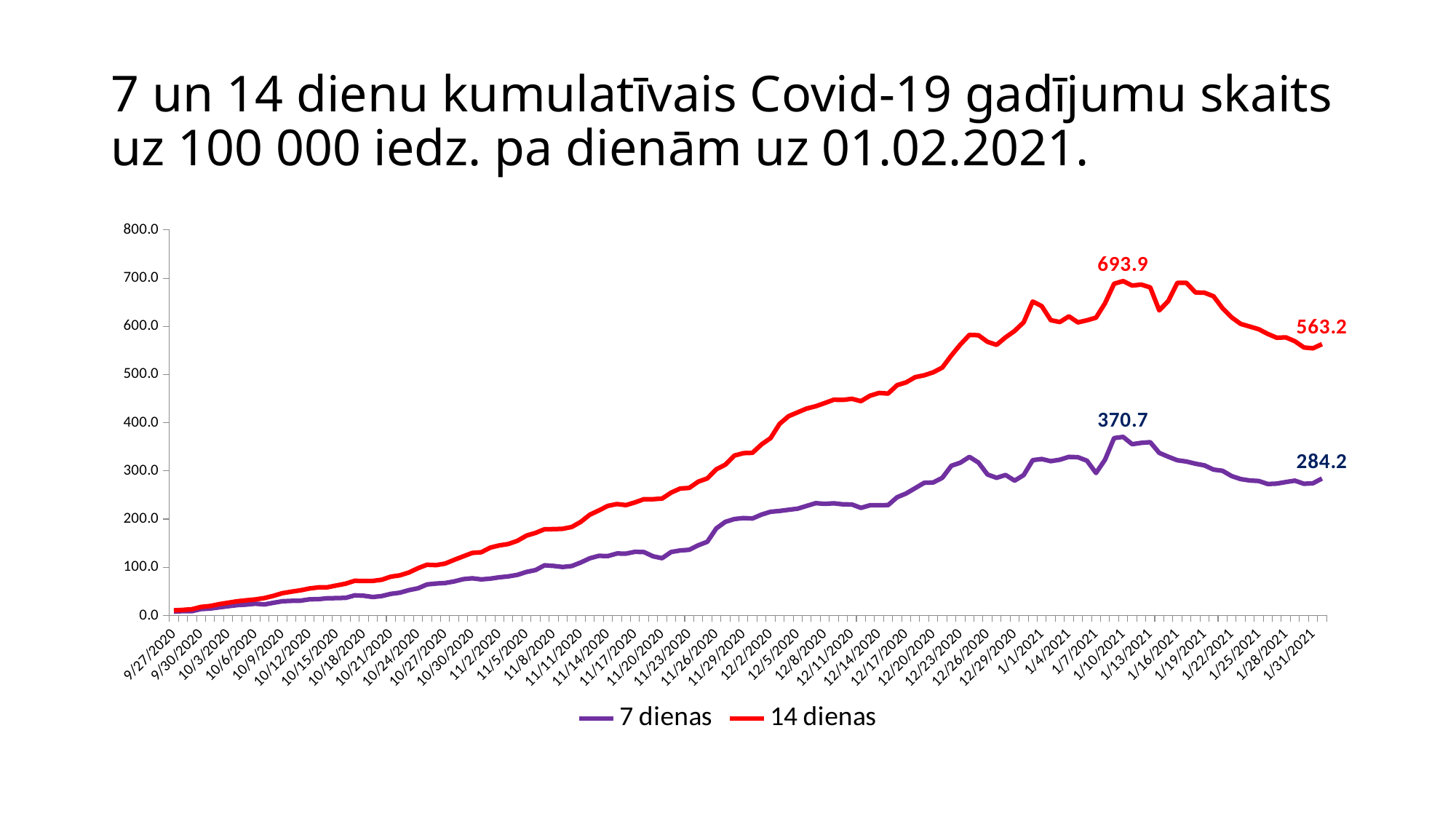
Is the value of the 14 dienas line on 1/1/2021 greater or less than 600? greater What is the last value labelled on the 7 dienas line (at 1/31/2021)? 284.2 How much did the 14 dienas value fall from its labelled peak of 693.9 to its final labelled value of 563.2? 130.7 What is the peak value labelled on the 7 dienas line? 370.7 Which series has the higher value at the end of the chart, 7 dienas or 14 dienas? 14 dienas What is the difference between the labelled peak values of the 14 dienas line (693.9) and the 7 dienas line (370.7)? 323.2 What colour is the 7 dienas line? purple Is the value of the 7 dienas line on 10/30/2020 greater or less than 100? less What is the peak value labelled on the 14 dienas line? 693.9 What is the last value labelled on the 14 dienas line (at 1/31/2021)? 563.2 What kind of chart is shown on the slide? line chart How many series does the legend list? 2